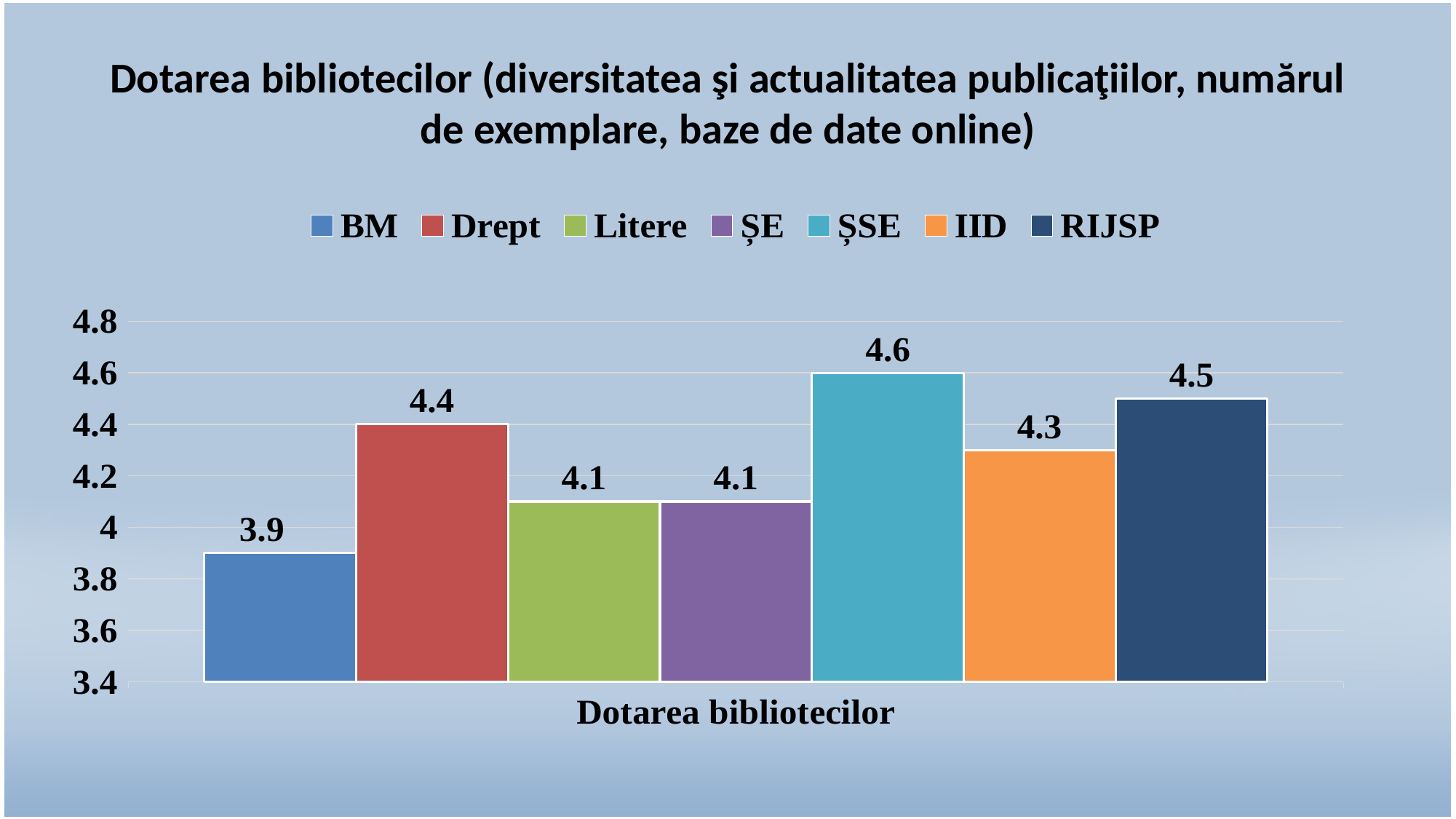
What kind of chart is shown on the slide? bar chart What is the value for Drept? 4.4 What is the label on the x axis of the chart? Dotarea bibliotecilor Which series has the lowest value? BM What is the difference between the values for ȘSE and BM? 0.7 Which is larger, the value for RIJSP or the value for Drept? RIJSP What is the value for BM? 3.9 What is the value for IID? 4.3 Which series has the highest value? ȘSE Is the value for Litere greater or less than 4.2? less How many series does the legend list? 7 What colour is the bar for ȘSE? teal